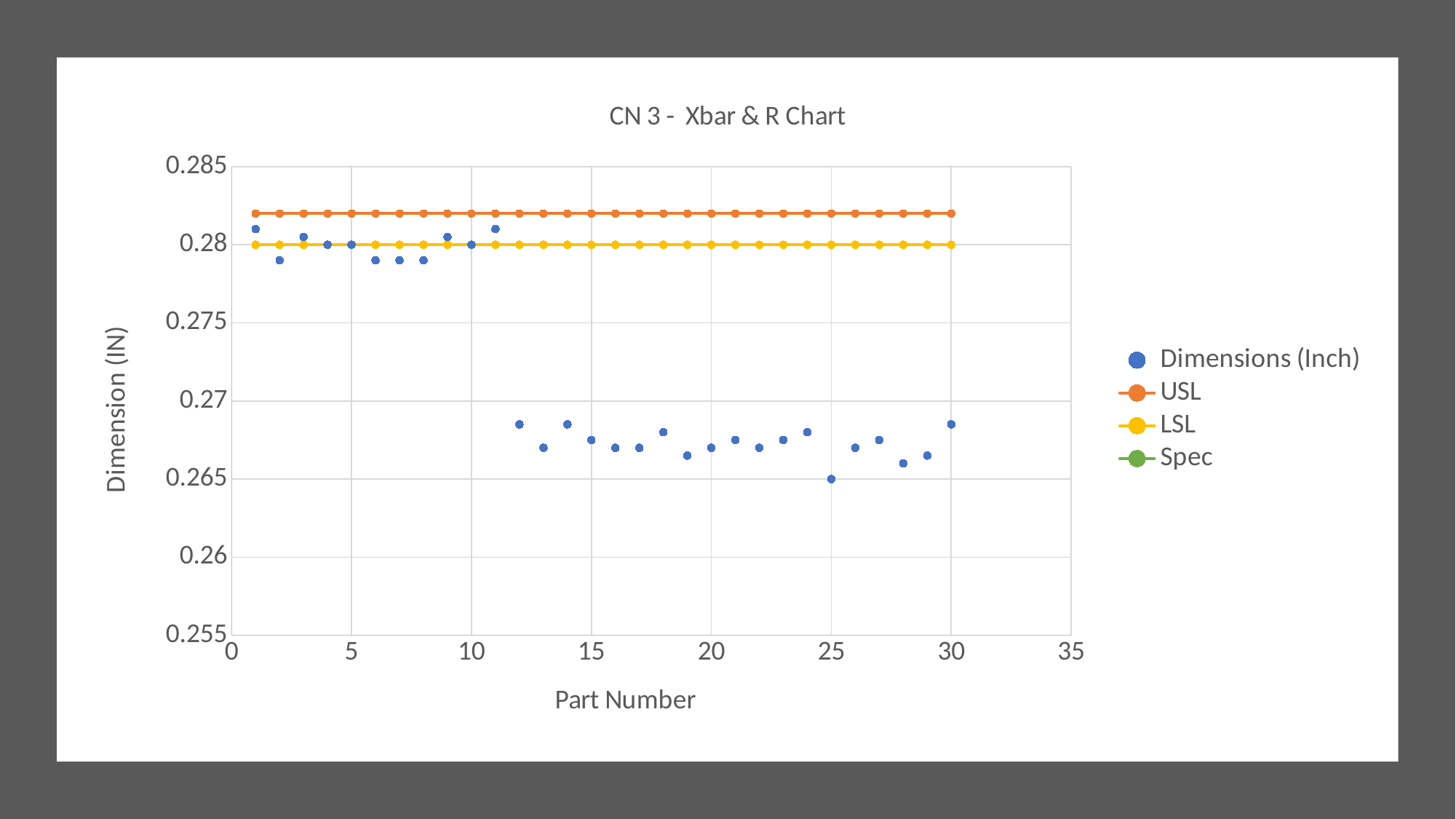
How many Dimensions (Inch) data points are plotted? 30 Which has the larger Dimensions (Inch) value, part number 1 or part number 12? Part number 1 Is the Dimensions (Inch) value for part number 12 greater or less than 0.27? less Which part number has the lowest Dimensions (Inch) value? 25 What is the label of the x axis? Part Number How many series does the legend list? 4 Is the USL line greater or less than 0.28? greater Do the Dimensions (Inch) values generally rise or fall from part number 1 to part number 30? fall What is the value of the LSL line? 0.28 What is the title of the chart? CN 3 - Xbar & R Chart What type of chart is shown on the slide? Scatter chart What is the Dimensions (Inch) value for part number 25? 0.265